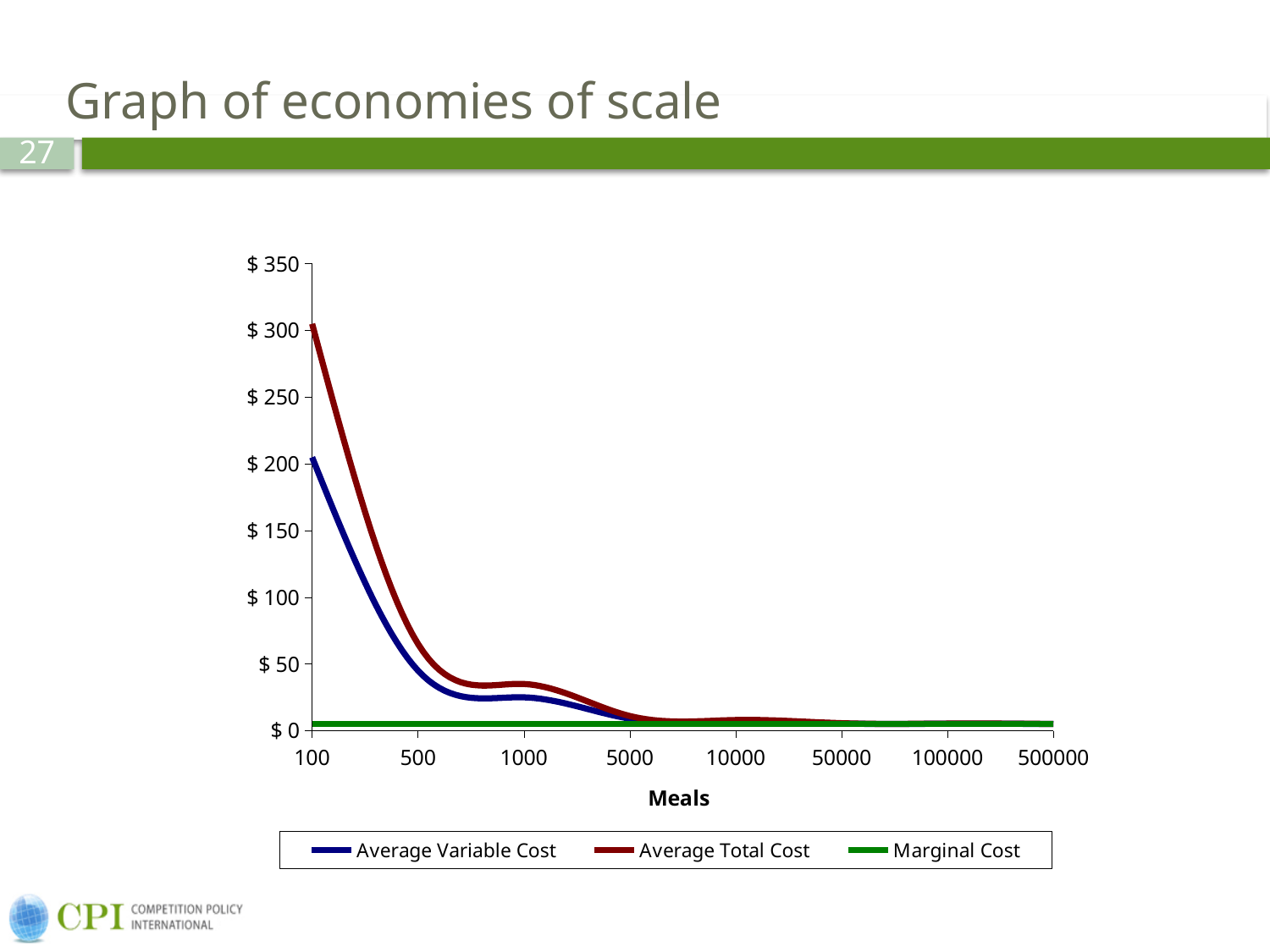
At 100 meals, which is larger: Average Total Cost or Average Variable Cost? Average Total Cost How many meal quantities are labelled along the x axis? 8 Which series has the highest value at 100 meals? Average Total Cost How many series does the legend list? 3 Which series has the lowest value at 100 meals? Marginal Cost Does the Average Variable Cost rise or fall as the number of meals increases? fall What is the title of the x axis? Meals What kind of chart is shown on the slide? line chart Is the Average Total Cost at 1000 meals greater or less than $100? less Is the Average Variable Cost at 100 meals greater or less than $150? greater Is the Average Total Cost at 100 meals greater or less than $250? greater